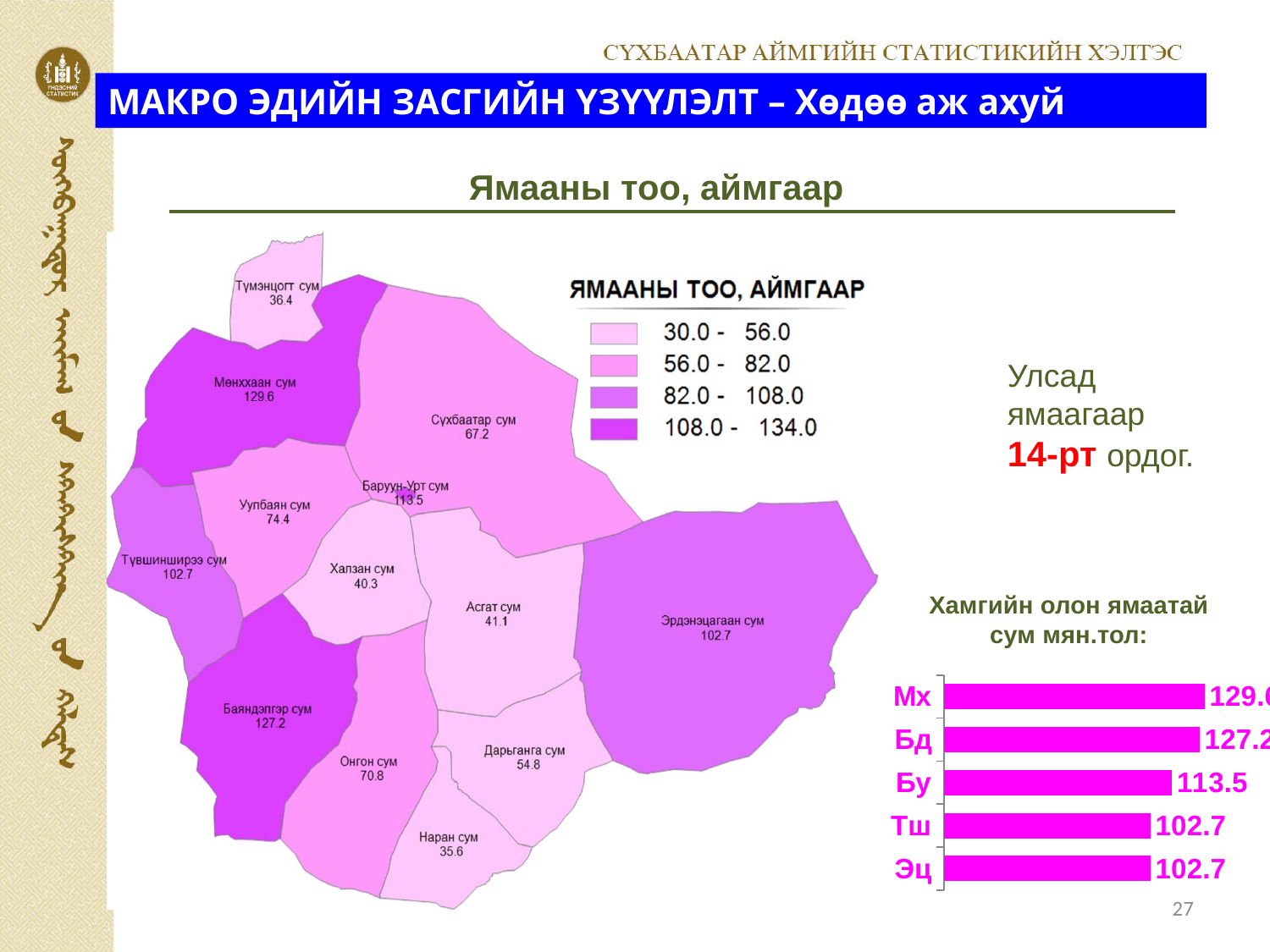
In the bar chart titled 'Хамгийн олон ямаатай сум мян.тол:', what colour are the bars? magenta In the bar chart titled 'Хамгийн олон ямаатай сум мян.тол:', what is the value for Бу? 113.5 On the map titled 'ЯМААНЫ ТОО, АЙМГААР', what is the value shown for Наран сум? 35.6 In the bar chart titled 'Хамгийн олон ямаатай сум мян.тол:', what is the value for Тш? 102.7 In the bar chart titled 'Хамгийн олон ямаатай сум мян.тол:', what is the difference between the values for Бу and Тш? 10.8 On the map titled 'ЯМААНЫ ТОО, АЙМГААР', what is the value shown for Сүхбаатар сум? 67.2 What kind of chart is the one titled 'Хамгийн олон ямаатай сум мян.тол:'? bar chart On the map titled 'ЯМААНЫ ТОО, АЙМГААР', how many value ranges does the legend list? 4 In the bar chart titled 'Хамгийн олон ямаатай сум мян.тол:', which category has the highest value? Мх In the bar chart titled 'Хамгийн олон ямаатай сум мян.тол:', how many categories are shown? 5 In the bar chart titled 'Хамгийн олон ямаатай сум мян.тол:', what is the value for Эц? 102.7 In the bar chart titled 'Хамгийн олон ямаатай сум мян.тол:', which is larger, the value for Бд or the value for Бу? Бд